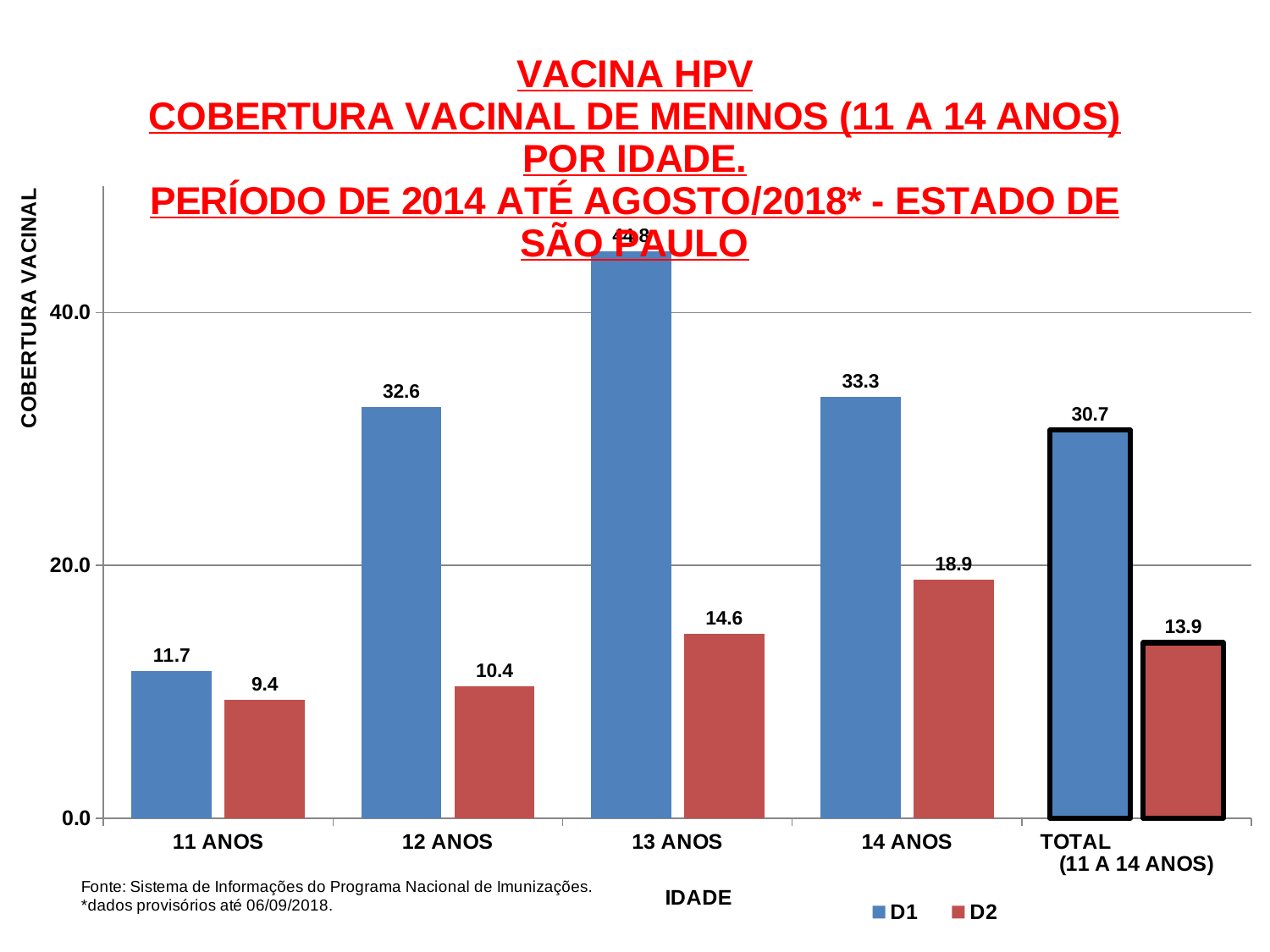
Which age category has the lowest D2 value? 11 ANOS How many series does the legend list? 2 Which age category has the highest D1 value? 13 ANOS What kind of chart is shown on the slide? bar chart Is the D1 value for 13 ANOS greater or less than 40.0? greater What is the D2 value for 14 ANOS? 18.9 What is the D1 value for TOTAL (11 A 14 ANOS)? 30.7 What is the difference between the D1 and D2 values for 14 ANOS? 14.4 Which is larger, the D2 value for 12 ANOS or the D2 value for 13 ANOS? 13 ANOS What is the D2 value for 11 ANOS? 9.4 What is the D1 value for 12 ANOS? 32.6 How many categories are shown on the x axis? 5